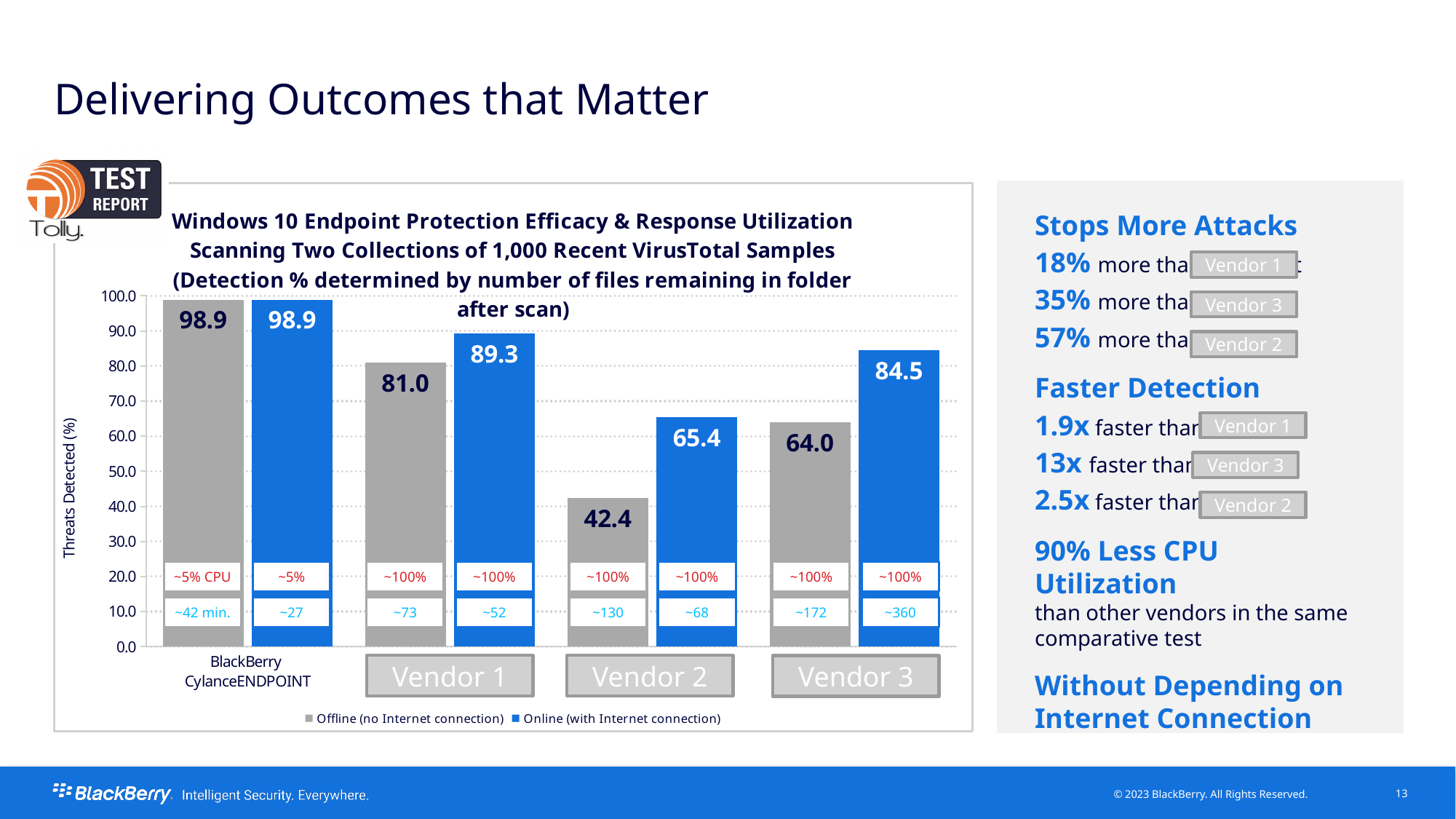
What is the difference between the Offline values for Vendor 1 and Vendor 3? 17.0 What is the label of the y axis of the chart? Threats Detected (%) Which category has the lowest Offline (no Internet connection) value? Vendor 2 What is the Online (with Internet connection) value for Vendor 3? 84.5 Which category has the highest Online (with Internet connection) value? BlackBerry CylanceENDPOINT What kind of chart is shown on the slide? Bar chart How many series does the chart legend list? 2 Which is larger: the Online value for Vendor 1 or the Online value for Vendor 3? Vendor 1 What is the Offline (no Internet connection) threats detected value for Vendor 1? 81.0 What is the difference between the Online and Offline values for Vendor 2? 23.0 What is the Online (with Internet connection) threats detected value for Vendor 2? 65.4 How many categories are shown on the x axis of the chart? 4